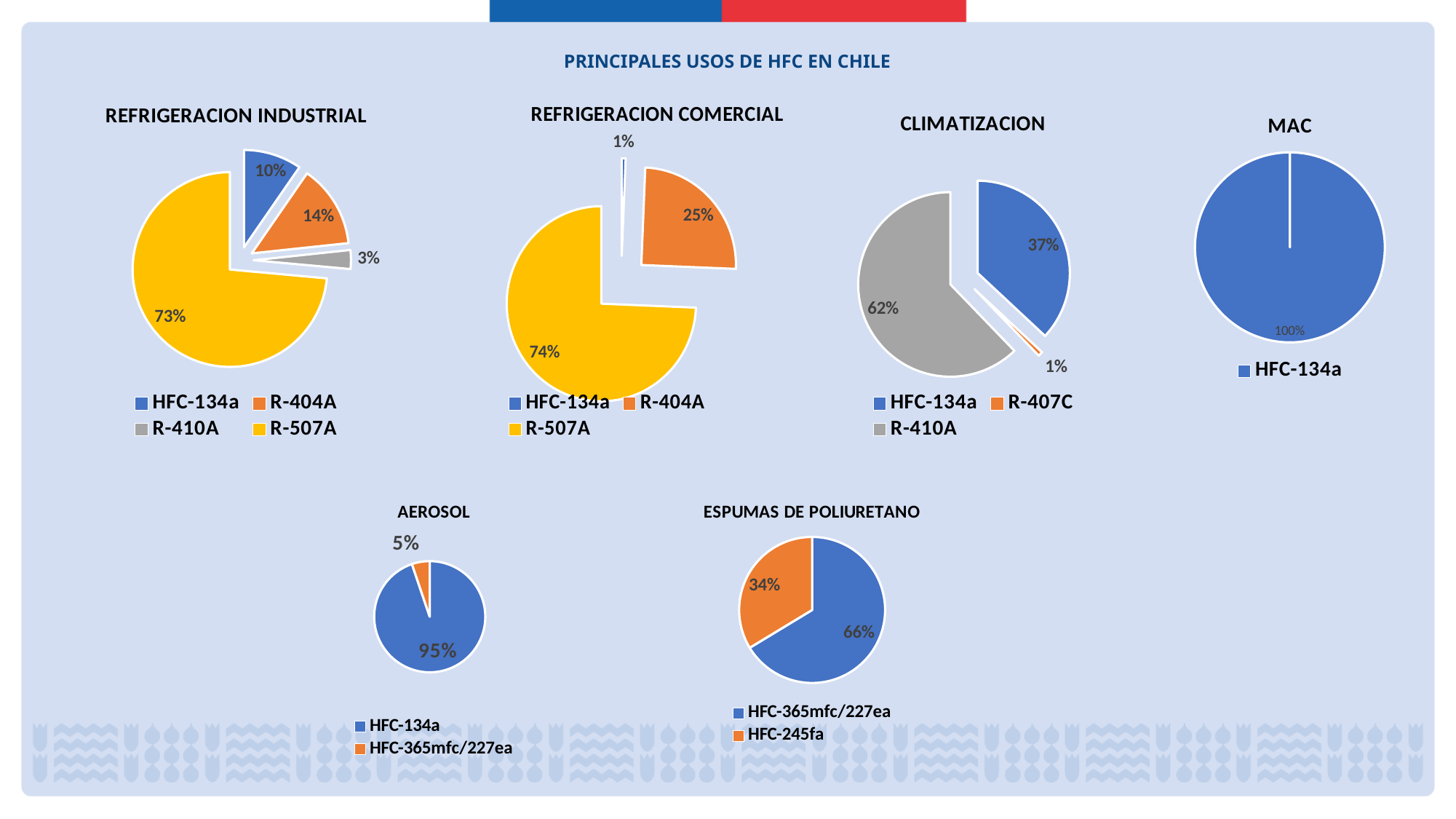
What kind of chart is the AEROSOL chart? Pie chart In the AEROSOL chart, which is larger, the share of HFC-134a or the share of HFC-365mfc/227ea? HFC-134a In the MAC chart, what share does HFC-134a have? 100% How many entries does the legend of the CLIMATIZACION chart list? 3 In the REFRIGERACION INDUSTRIAL chart, which refrigerant has the smallest share? R-410A In the CLIMATIZACION chart, what is the difference between the R-410A share and the HFC-134a share? 25% In the REFRIGERACION INDUSTRIAL chart, what share does R-507A have? 73% How many slices does the REFRIGERACION INDUSTRIAL chart have? 4 In the REFRIGERACION COMERCIAL chart, what share does R-404A have? 25% In the REFRIGERACION COMERCIAL chart, which refrigerant has the largest share? R-507A In the ESPUMAS DE POLIURETANO chart, what share does HFC-245fa have? 34% In the CLIMATIZACION chart, what share does R-407C have? 1%